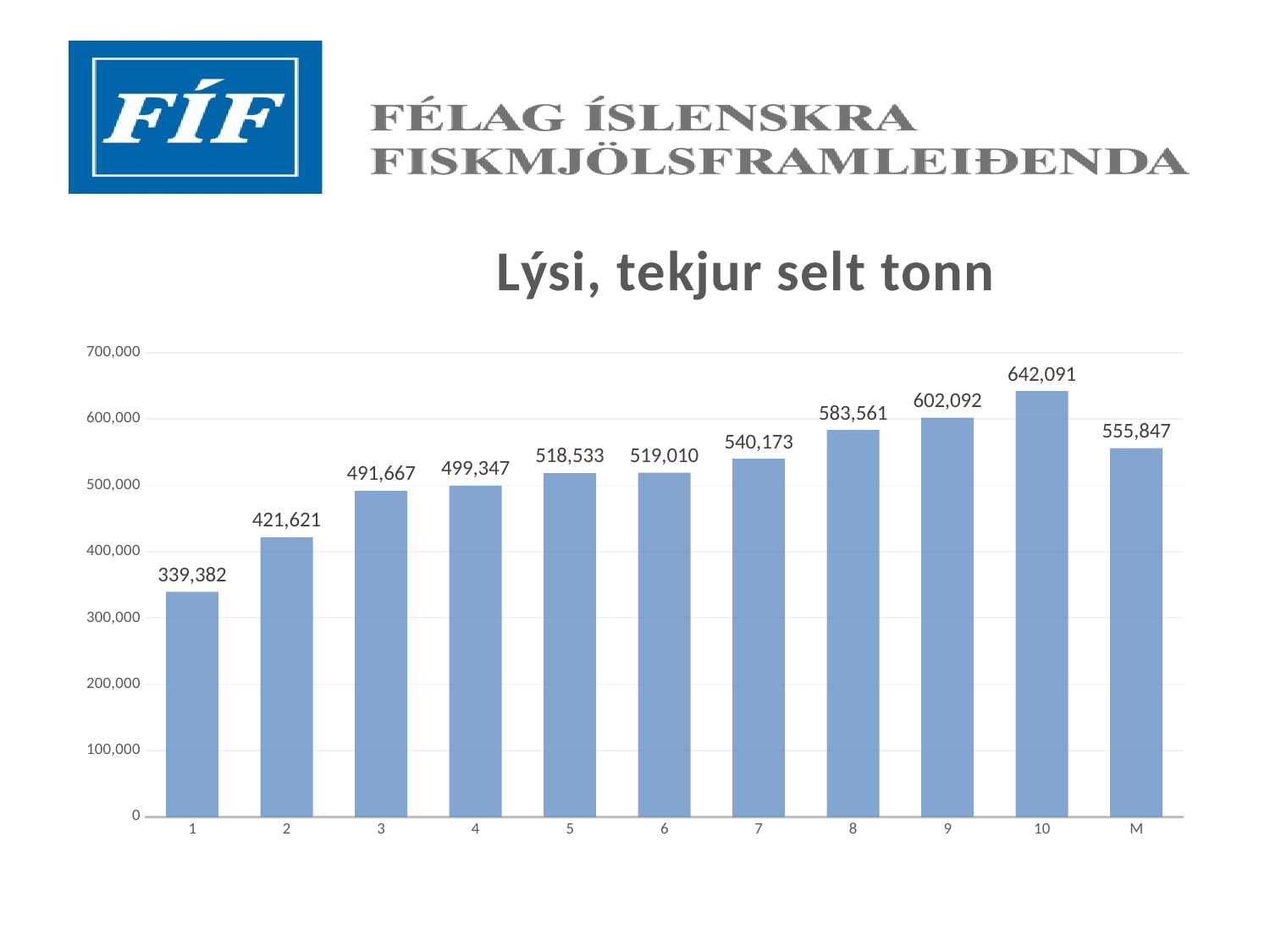
Which category has the highest value? 10 What is the value for category 1? 339,382 What type of chart is shown on the slide? bar chart Which category has the lowest value? 1 What is the difference between the values for category 10 and category 1? 302,709 What is the difference between the values for category 9 and category 8? 18,531 What is the value for category 7? 540,173 How many categories are shown on the x axis? 11 Is the value for category 2 greater or less than 400,000? greater What is the title of the chart? Lýsi, tekjur selt tonn What is the value for category M? 555,847 Which is larger, the value for category 8 or the value for category M? category 8